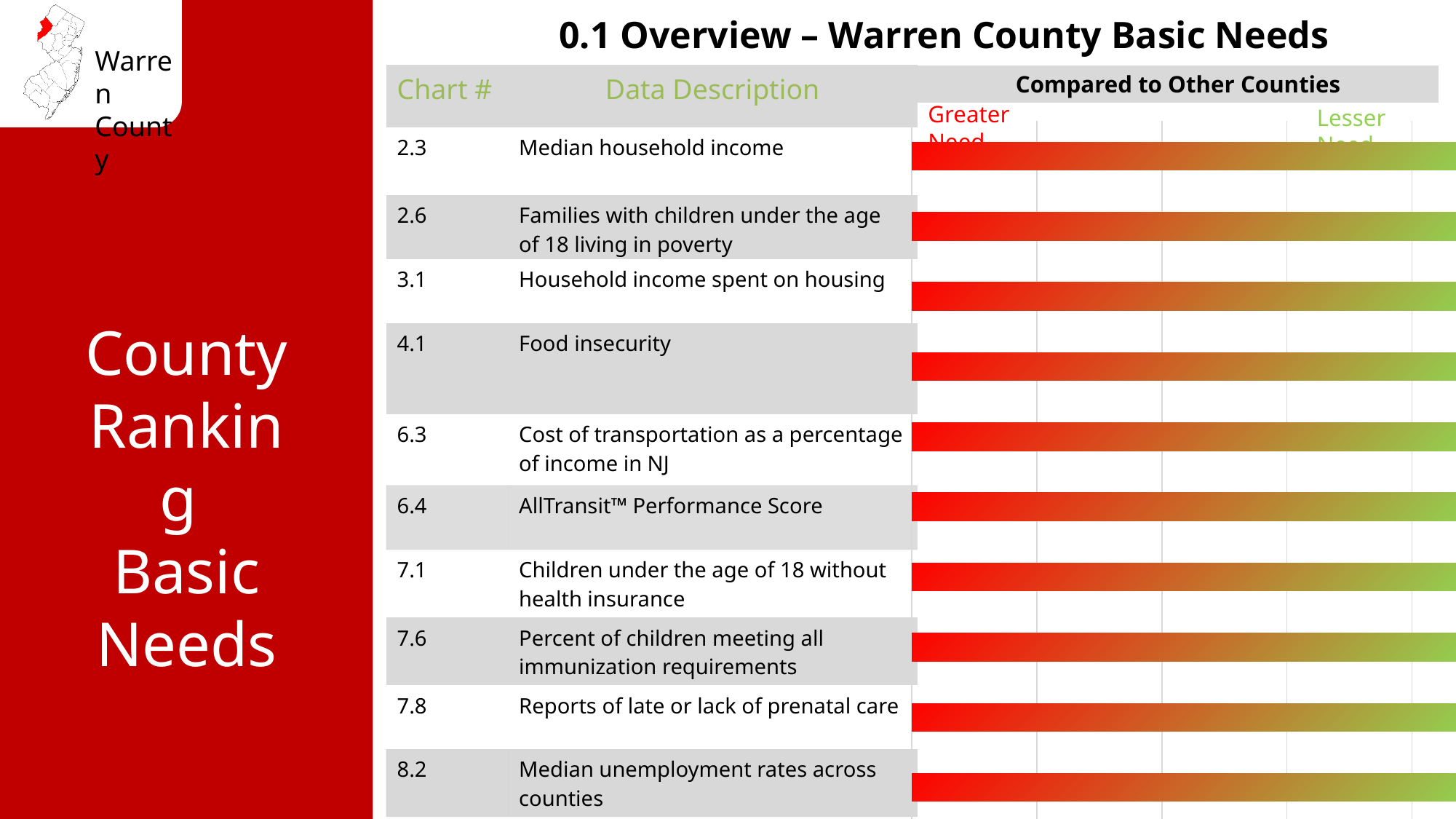
What label appears at the right end of the chart's horizontal axis? Lesser Need Which data description corresponds to chart number 7.8? Reports of late or lack of prenatal care What label appears at the left end of the chart's horizontal axis? Greater Need How many data descriptions are listed in the table next to the chart? 10 How many bars are plotted in the "Compared to Other Counties" chart? 10 Which chart number corresponds to the bar for "Food insecurity"? 4.1 Which data description is listed last (bottom bar) in the chart? Median unemployment rates across counties Which chart number corresponds to "Median household income"? 2.3 What kind of chart is shown under "Compared to Other Counties"? bar chart